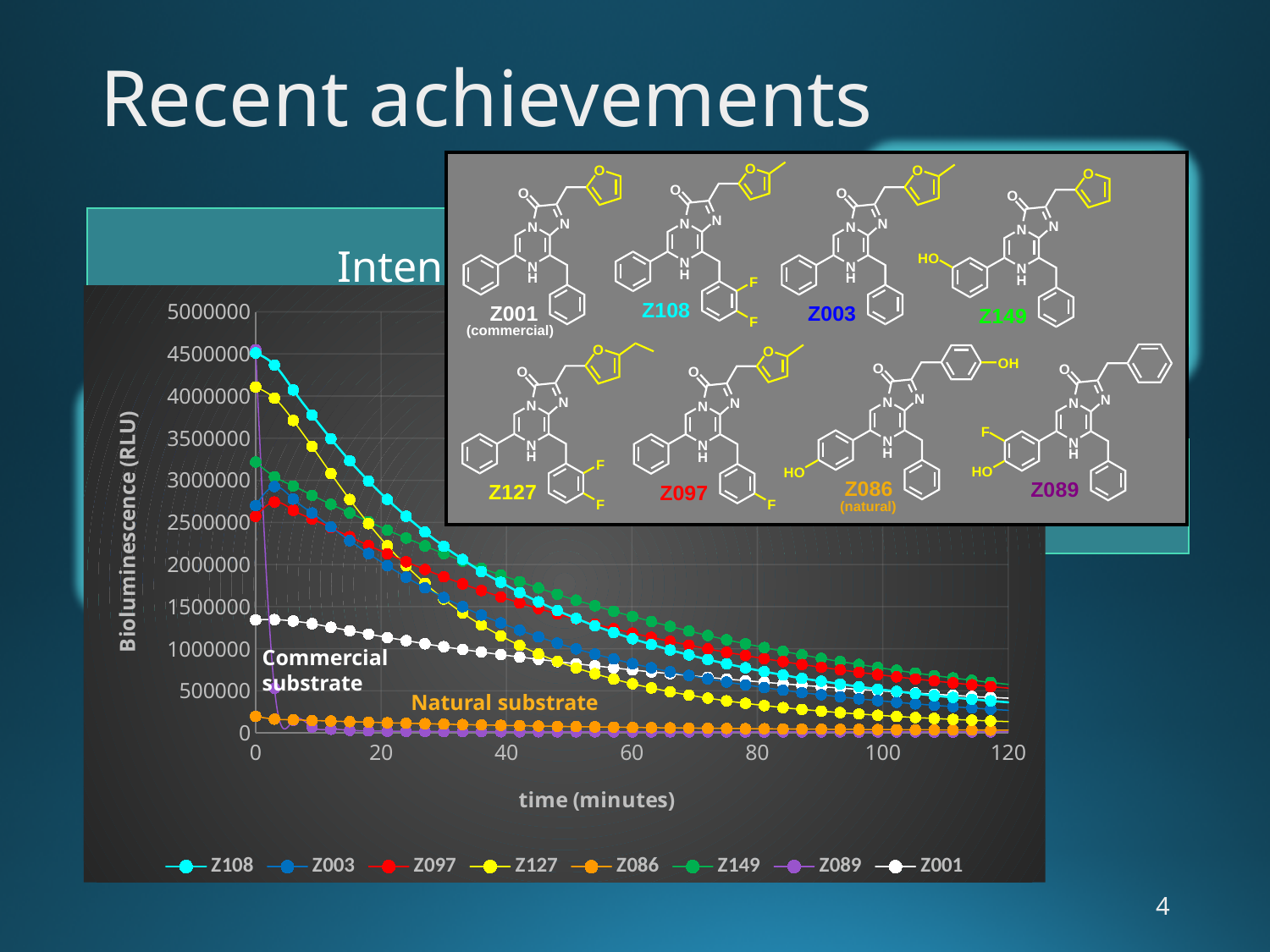
What is the title of the y axis of the chart? Bioluminescence (RLU) What is the title of the x axis of the chart? time (minutes) Is the value for Z001 at time 0 greater or less than 1500000? less Which series has the lowest bioluminescence value at 120 minutes? Z089 Is the value for Z086 at 60 minutes greater or less than 500000? less Is the value for Z108 at time 0 greater or less than 4000000? greater Does the bioluminescence for Z108 rise or fall as time increases from 0 to 120 minutes? fall At 120 minutes, which series has the larger value, Z086 or Z089? Z086 How many series does the chart legend list? 8 At time 0, which series has the larger value, Z108 or Z001? Z108 What kind of chart is shown on the slide? line chart